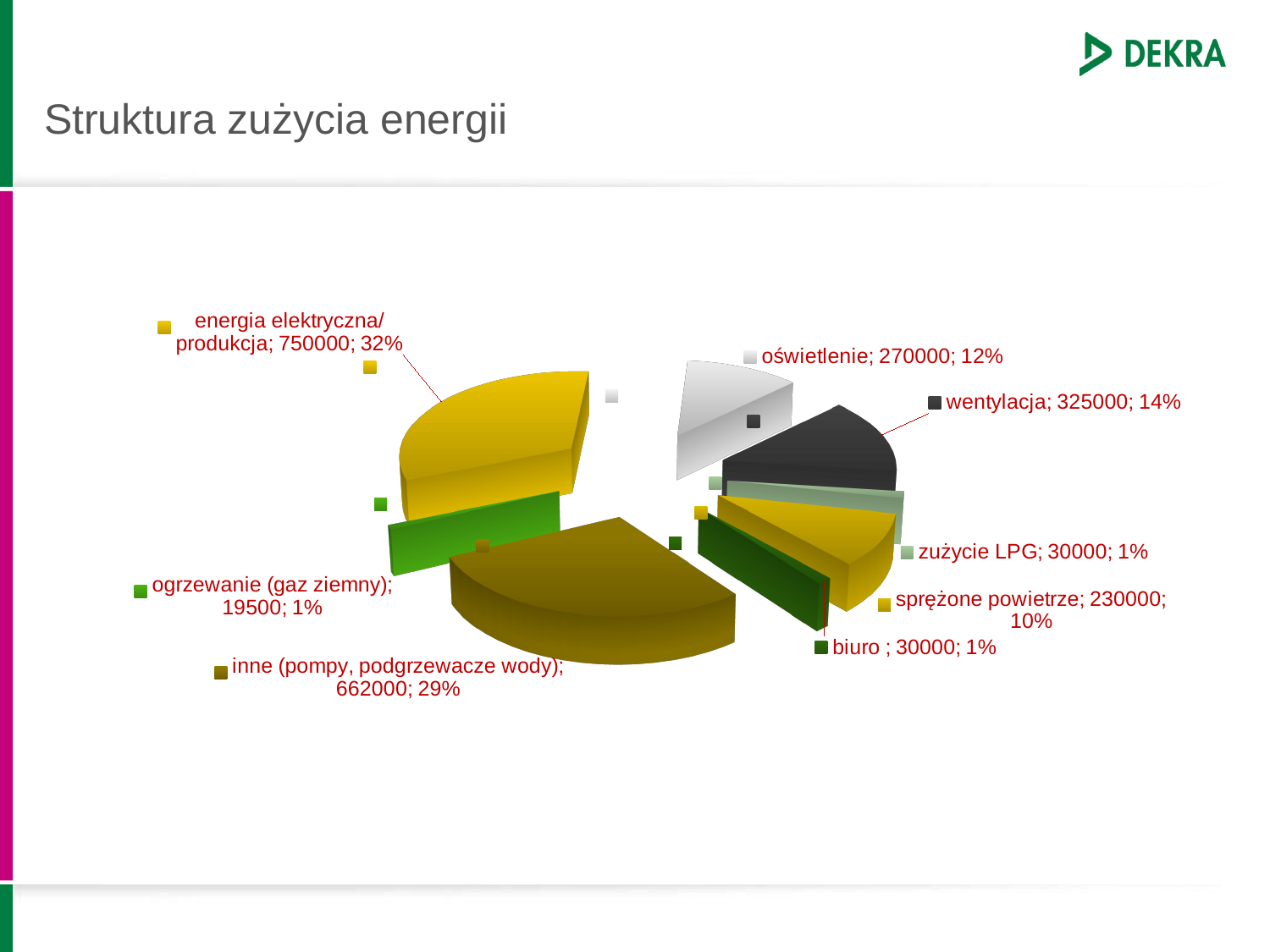
Which category has the largest share of the pie? energia elektryczna/produkcja What is the title of the slide containing the chart? Struktura zużycia energii What is the value for wentylacja? 325000 Which category has the smallest value? ogrzewanie (gaz ziemny) Which is larger, the value for sprężone powietrze or the value for oświetlenie? oświetlenie What type of chart is shown on the slide? pie chart What is the difference between the values for wentylacja and oświetlenie? 55000 What percentage share does oświetlenie have? 12% How many categories are shown in the pie chart? 8 What is the value for ogrzewanie (gaz ziemny)? 19500 What percentage share does inne (pompy, podgrzewacze wody) have? 29% What is the value for energia elektryczna/produkcja? 750000